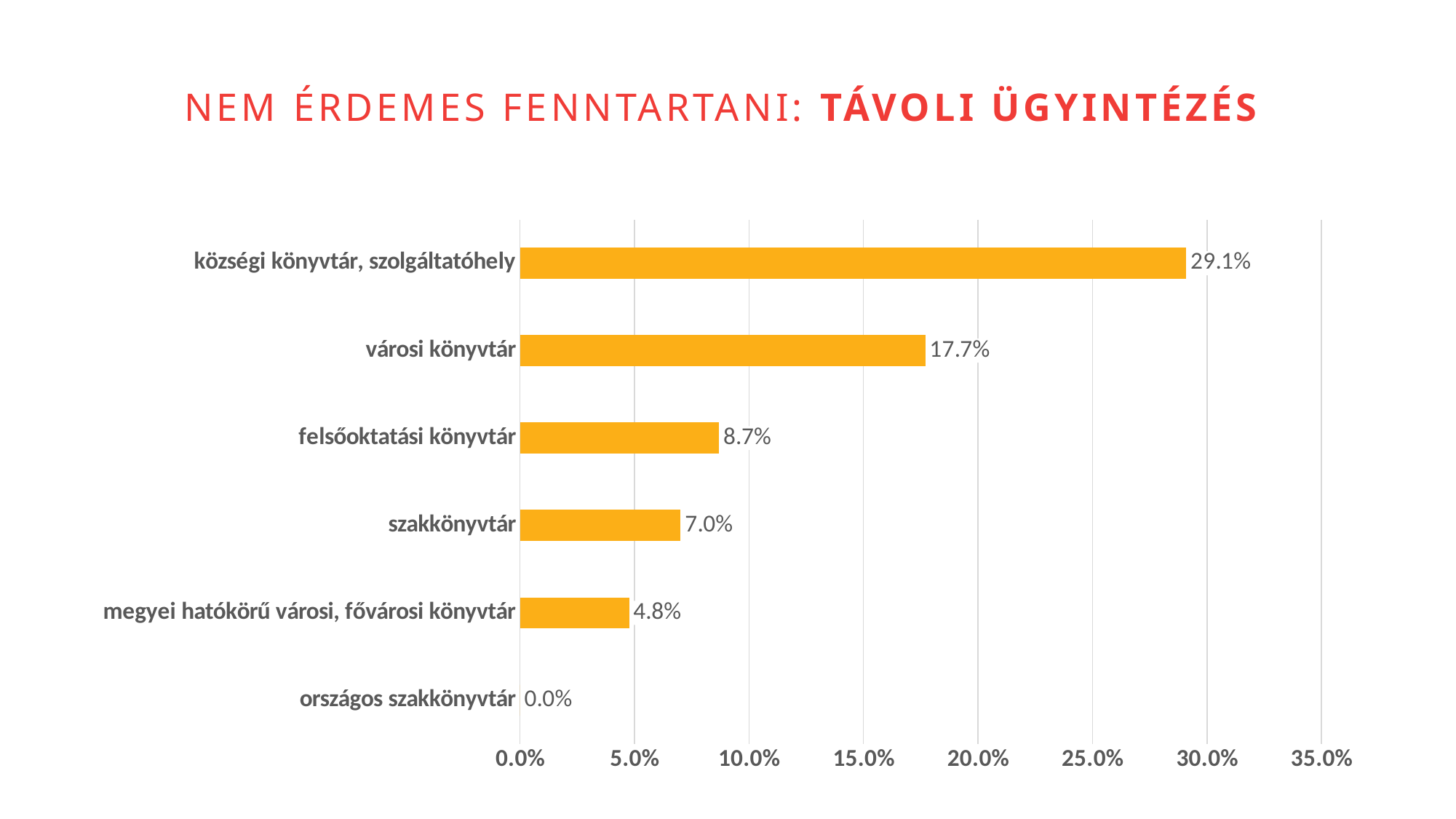
Which category has the highest value? községi könyvtár, szolgáltatóhely What is the value for megyei hatókörű városi, fővárosi könyvtár? 4.8% What is the title of the slide? NEM ÉRDEMES FENNTARTANI: TÁVOLI ÜGYINTÉZÉS Which category has the lowest value? országos szakkönyvtár What kind of chart is shown on the slide? bar chart Is the value for városi könyvtár greater or less than 15.0%? greater What is the value for községi könyvtár, szolgáltatóhely? 29.1% What is the value for felsőoktatási könyvtár? 8.7% How many categories are shown in the chart? 6 What is the value for városi könyvtár? 17.7% What is the difference between the values for községi könyvtár, szolgáltatóhely and városi könyvtár? 11.4% Which is larger, the value for felsőoktatási könyvtár or the value for szakkönyvtár? felsőoktatási könyvtár